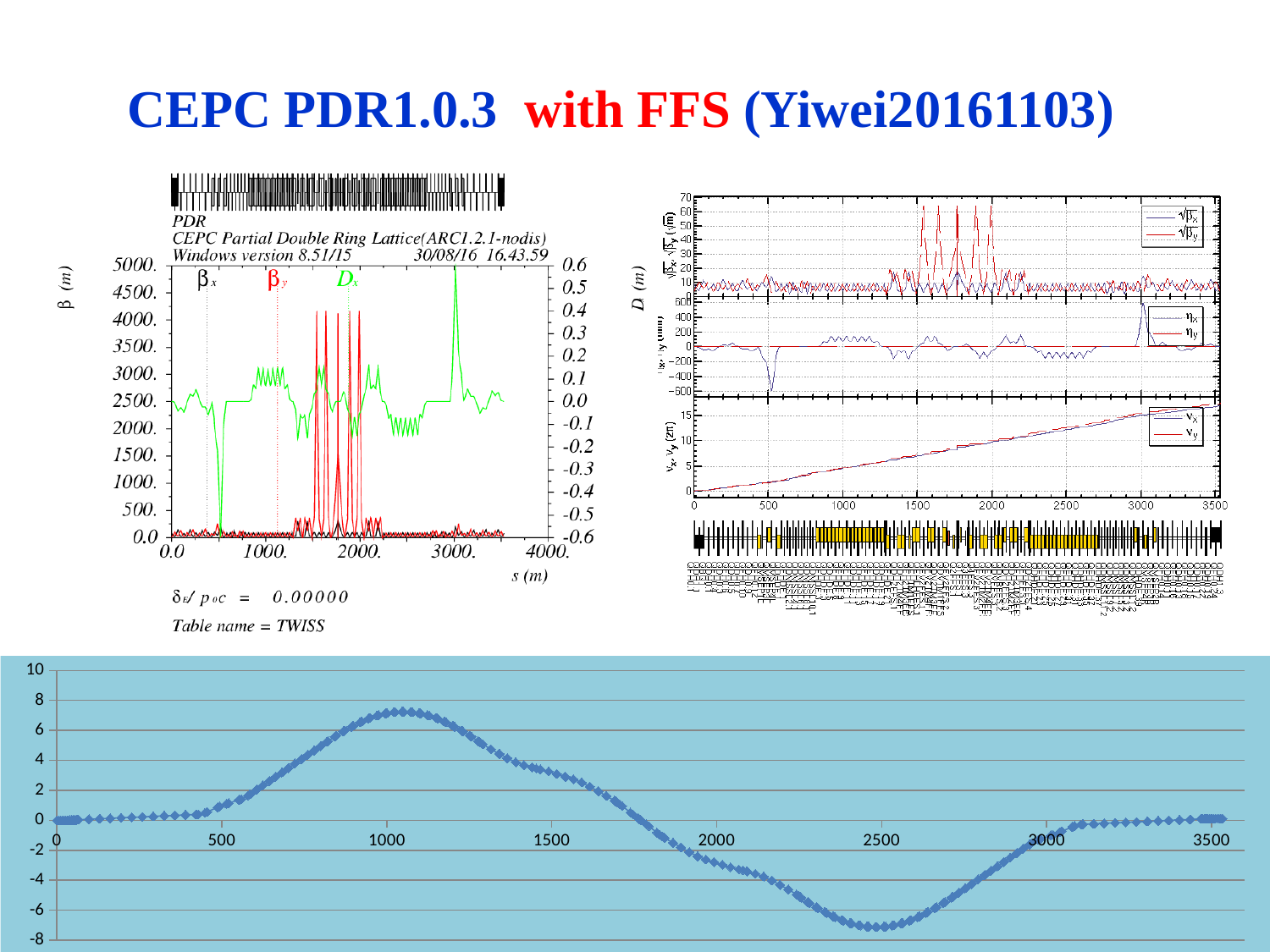
How many series are labelled in the top-left chart? 3 In the bottom chart, do the values rise or fall between x = 500 and x = 1000? rise What kind of chart is the chart at the bottom of the slide? line chart In the bottom chart, do the values rise or fall between x = 1000 and x = 2500? fall In the top-left chart, is the peak of the red βy curve greater or less than 3500 on the left axis? greater In the bottom chart, is the value at x = 1000 greater or less than 6? greater In the bottom chart, what is the highest value shown on the y axis? 10 In the bottom chart, is the value at x = 2000 greater or less than 0? less In the top-right chart, do the νx and νy curves in the bottom panel rise or fall along the x axis? rise What is the title printed on the top-left chart? CEPC Partial Double Ring Lattice(ARC1.2.1-nodis) In the top-right chart, how many series does the legend of the middle panel list? 2